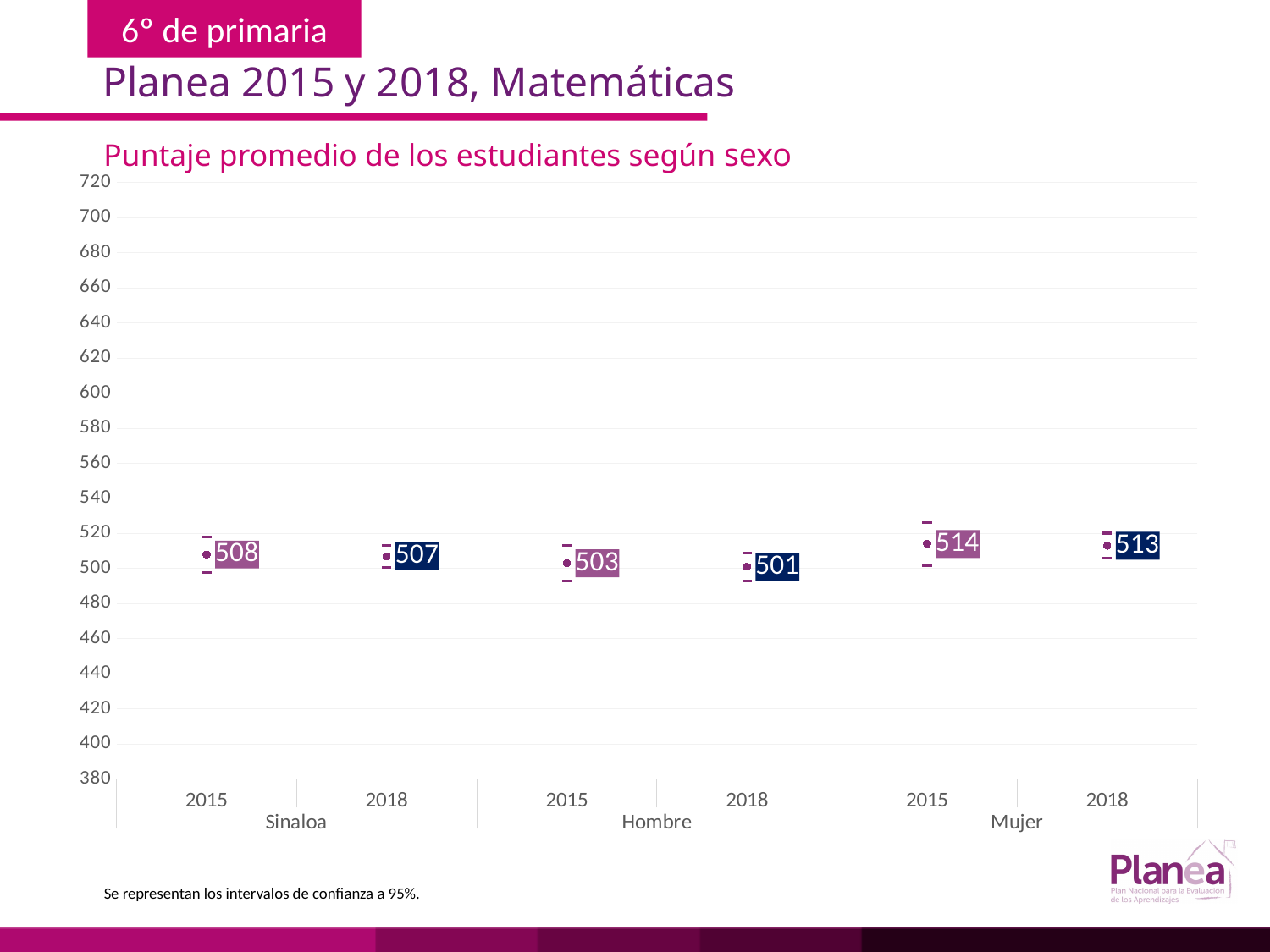
What is the average score for Mujer in 2018? 513 What is the title of the chart? Puntaje promedio de los estudiantes según sexo Did the Hombre score rise or fall from 2015 to 2018? fall What is the average score for Hombre in 2018? 501 What is the difference between the Sinaloa 2015 score and the Sinaloa 2018 score? 1 Which group and year has the highest average score? Mujer 2015 What is the difference between the Mujer 2015 score and the Hombre 2015 score? 11 What is the average score for Sinaloa in 2015? 508 Which is larger, the Mujer 2018 score or the Hombre 2018 score? Mujer 2018 How many data points are plotted on the chart? 6 What is the average score for Mujer in 2015? 514 Which group and year has the lowest average score? Hombre 2018